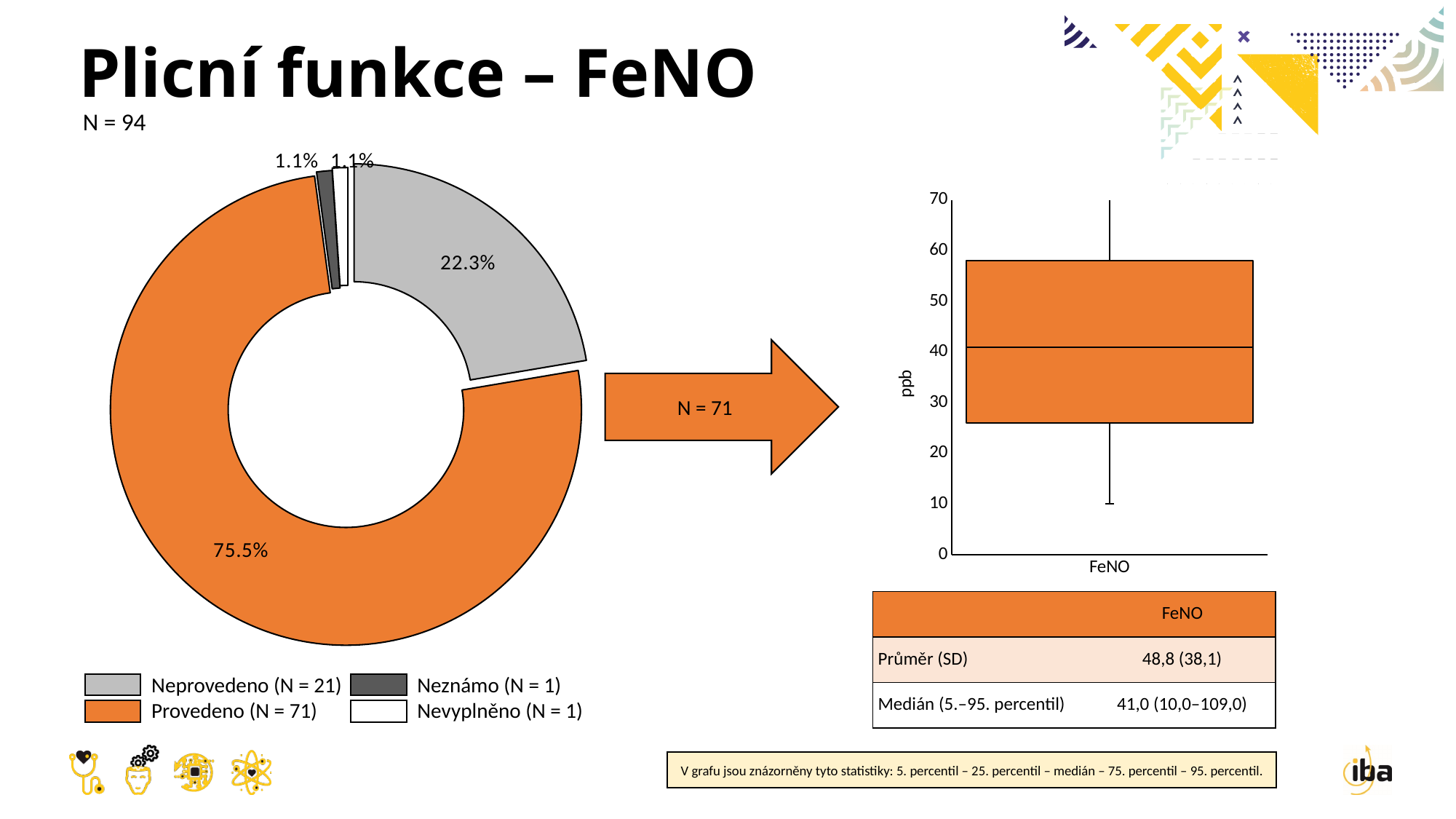
On the donut chart on the left, which is larger, the Neprovedeno slice or the Neznámo slice? Neprovedeno On the donut chart on the left, how many categories does the legend list? 4 On the box plot on the right, is the median line for FeNO greater or less than 30 ppb? greater On the donut chart on the left, what share of the pie does the Provedeno slice represent? 75.5% What kind of chart is shown on the left of the slide? Pie chart (donut) On the donut chart on the left, which category has the largest slice? Provedeno On the donut chart on the left, what is the N value shown in the legend for Neprovedeno? N = 21 On the donut chart on the left, what percentage is shown for the Neprovedeno slice? 22.3% On the donut chart on the left, what is the difference in percentage points between the Provedeno and Neprovedeno slices? 53.2 What kind of chart is shown on the right of the slide? Box plot On the box plot on the right, what unit is shown on the y axis? ppb On the donut chart on the left, what percentage is shown for the Neznámo slice? 1.1%